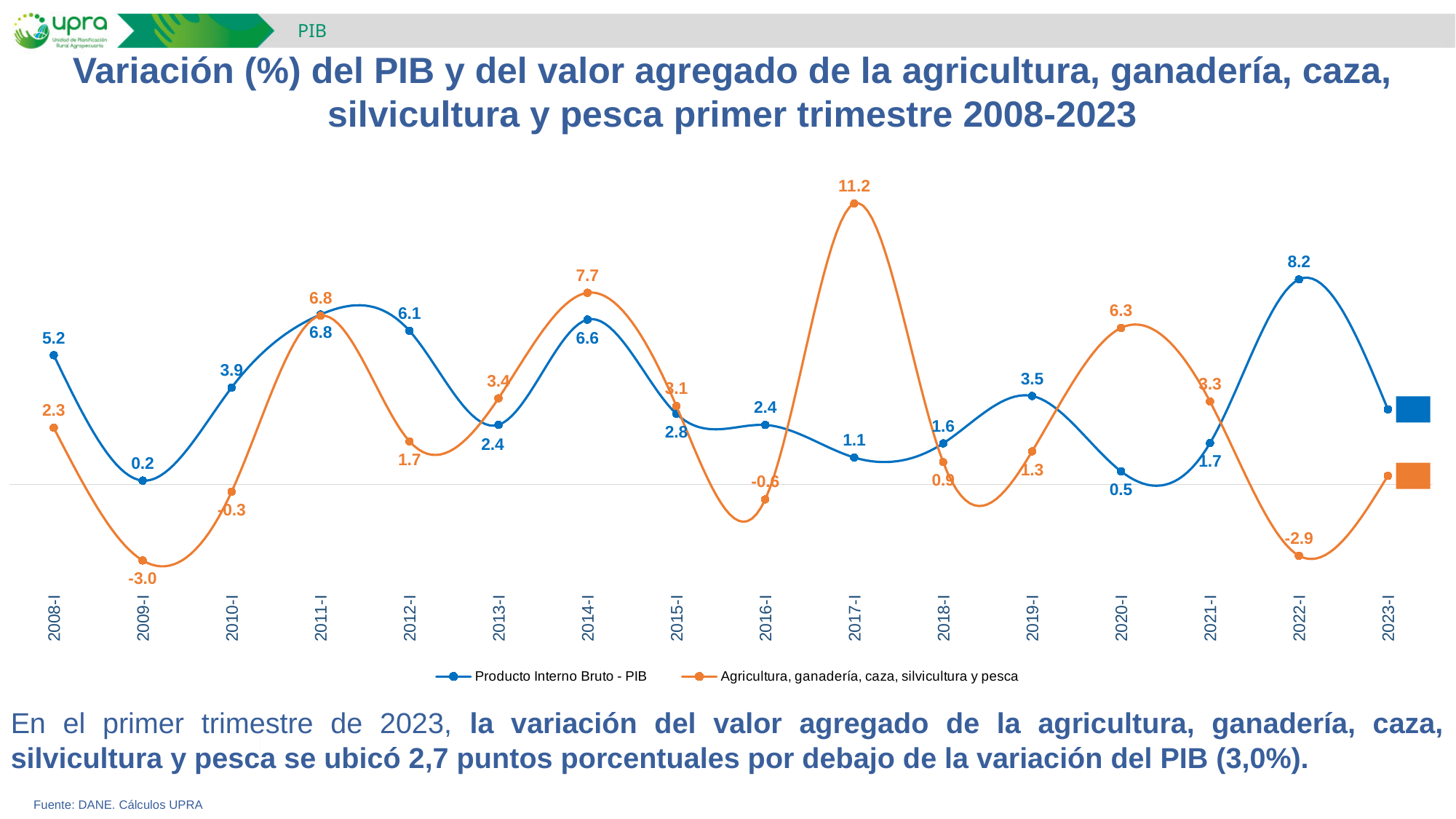
What is the value of Agricultura, ganadería, caza, silvicultura y pesca for 2017-I? 11.2 What is the difference between the Agricultura value and the PIB value in 2014-I? 1.1 How many series does the legend list? 2 In which period does the Agricultura, ganadería, caza, silvicultura y pesca series reach its lowest value? 2009-I What is the difference between the PIB value and the Agricultura value in 2022-I? 11.1 What is the value of Producto Interno Bruto - PIB for 2022-I? 8.2 What kind of chart is shown on the slide? Line chart In which period does the Agricultura, ganadería, caza, silvicultura y pesca series reach its highest value? 2017-I In 2020-I, which series has the larger value, PIB or Agricultura, ganadería, caza, silvicultura y pesca? Agricultura, ganadería, caza, silvicultura y pesca In which period does the Producto Interno Bruto - PIB series reach its highest value? 2022-I What is the value of Producto Interno Bruto - PIB for 2009-I? 0.2 How many periods are shown on the x axis? 16